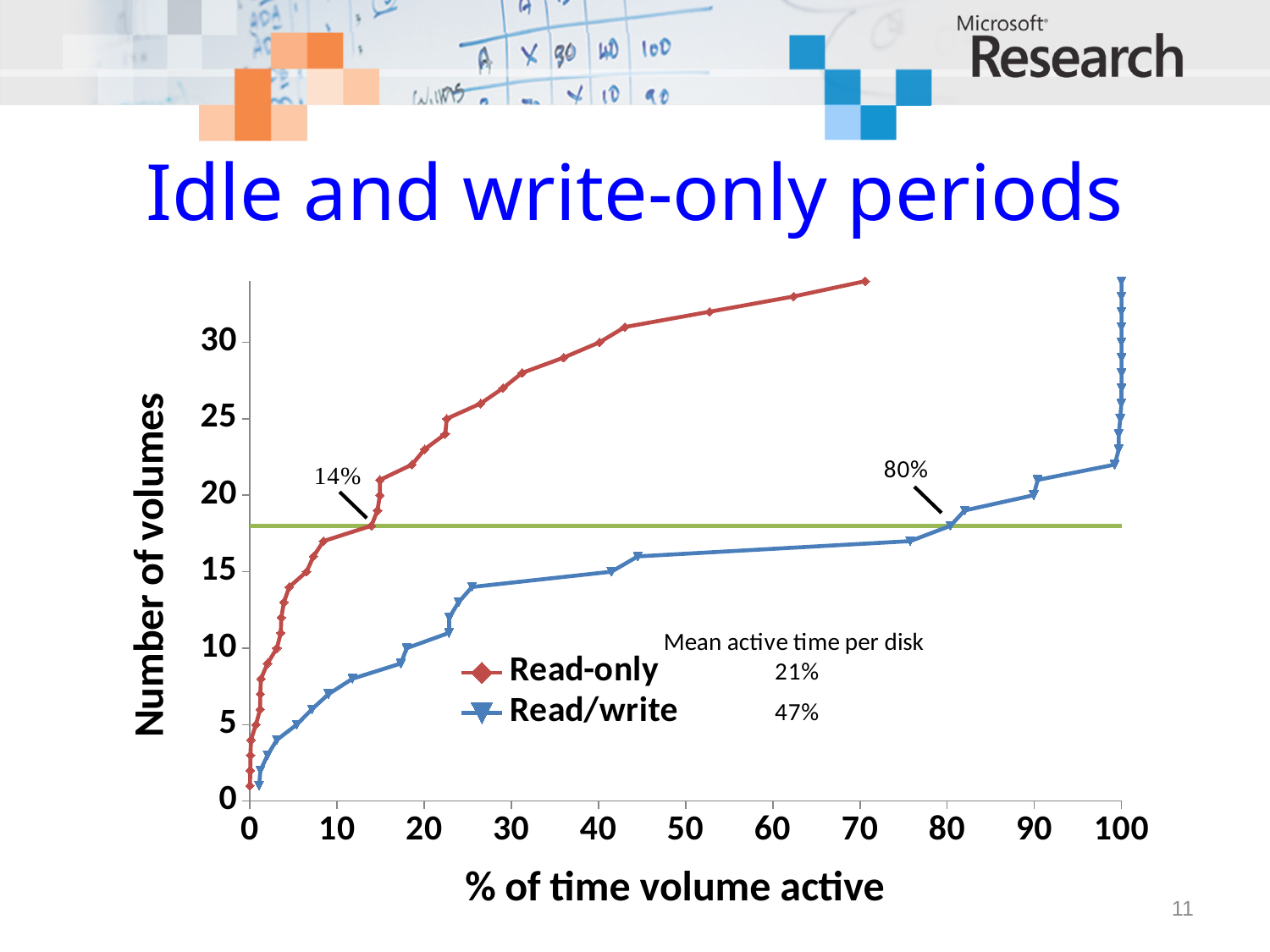
At what % of time volume active does the Read/write curve cross the green horizontal line, according to the annotation? 80% What is the label of the x axis? % of time volume active What is the difference between the mean active time per disk of the Read/write series and the Read-only series? 26 percentage points What kind of chart is shown on the slide? line chart What is the mean active time per disk for the Read-only series? 21% At what % of time volume active does the Read-only curve cross the green horizontal line, according to the annotation? 14% Which series has the higher mean active time per disk, Read-only or Read/write? Read/write Do the number of volumes for both series rise or fall as % of time volume active increases? rise How many series does the legend list? 2 What are the two series named in the legend? Read-only and Read/write Is the number of volumes for the Read/write series at 50% of time volume active greater or less than 20? less What is the mean active time per disk for the Read/write series? 47%